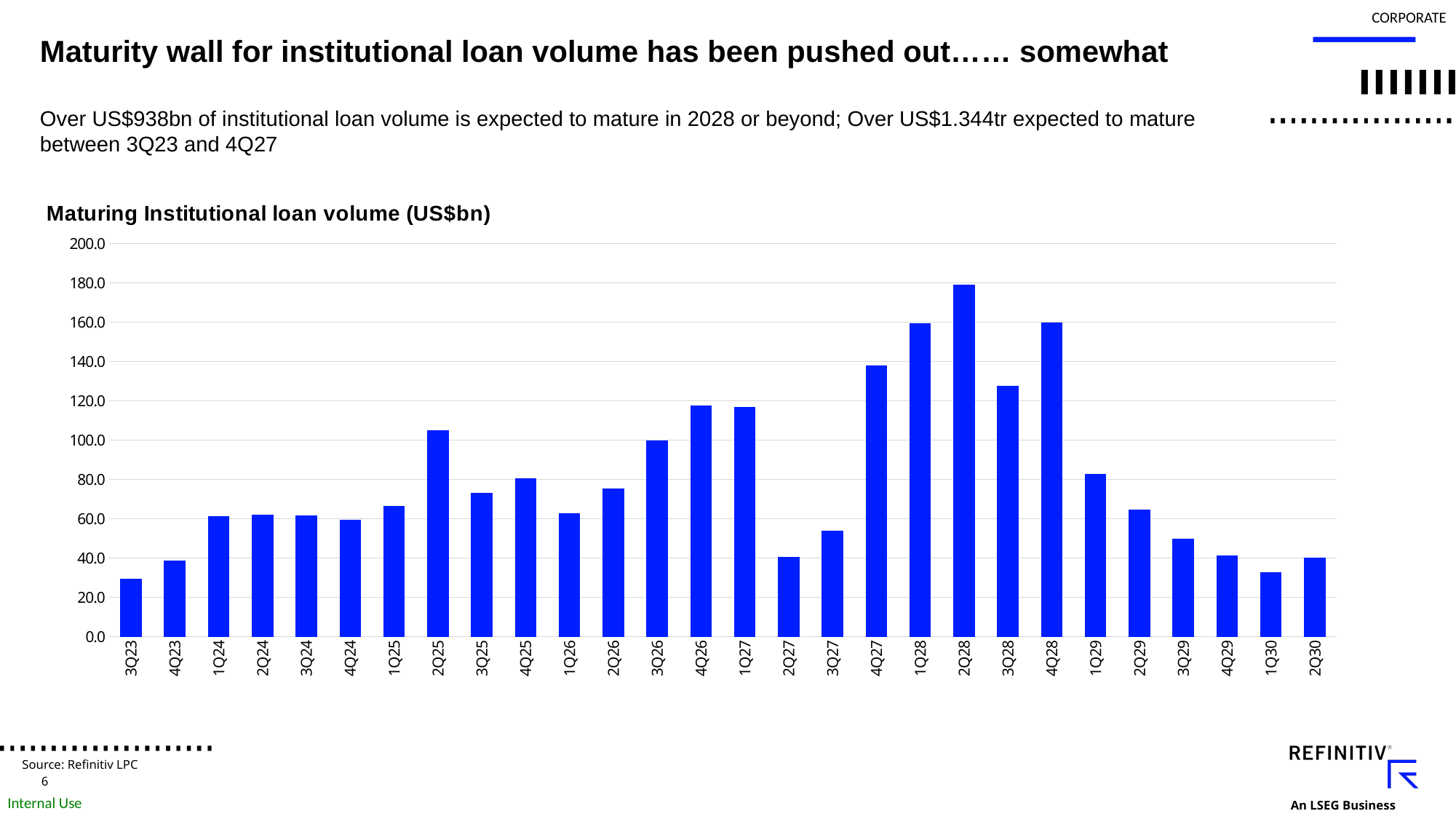
Is the value for 2Q25 greater or less than 100? greater Which quarter has the highest maturing institutional loan volume? 2Q28 Is the value for 1Q30 greater or less than 40? less Is the value for 3Q27 greater or less than 60? less Do the values rise or fall from 2Q28 to 1Q30? fall Which is larger, the value for 4Q27 or the value for 3Q28? 4Q27 What is the title of the chart? Maturing Institutional loan volume (US$bn) Which is larger, the value for 2Q28 or the value for 4Q28? 2Q28 How many quarters are plotted on the x axis of the chart? 28 What kind of chart is shown on the slide? bar chart